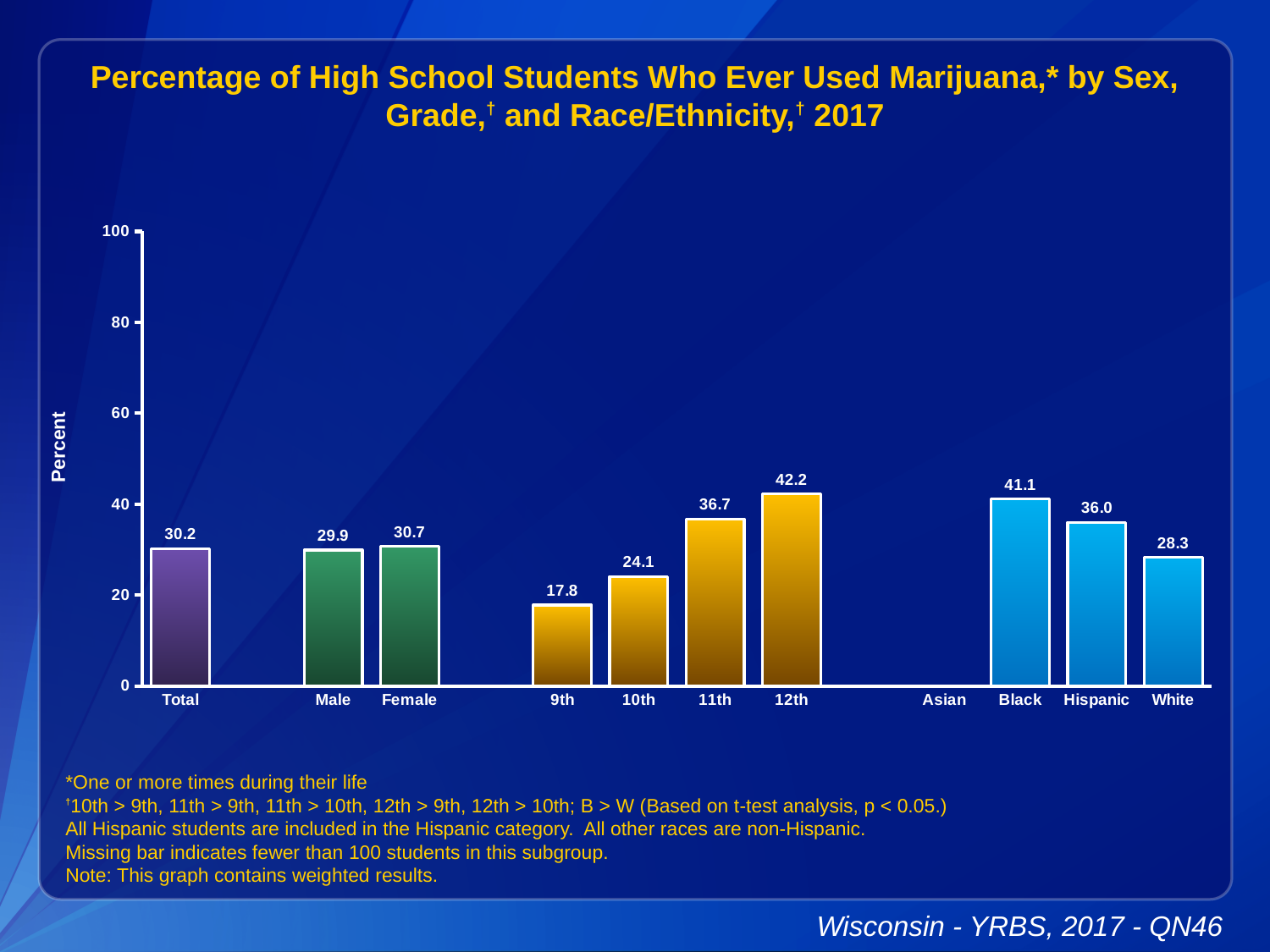
Is the value for 10th grade greater or less than 20? greater Which category on the x axis has no bar shown? Asian What is the difference between the values for Female and Male? 0.8 What is the value for Hispanic students? 36.0 Which category has the highest value? 12th Which is larger, the value for 11th grade or the value for Hispanic students? 11th What is the difference between the values for Black and White students? 12.8 What is the value for 12th grade? 42.2 What kind of chart is shown? bar chart Which category with a bar has the lowest value? 9th What is the value for Total? 30.2 Do the values rise or fall from 9th grade to 12th grade? rise